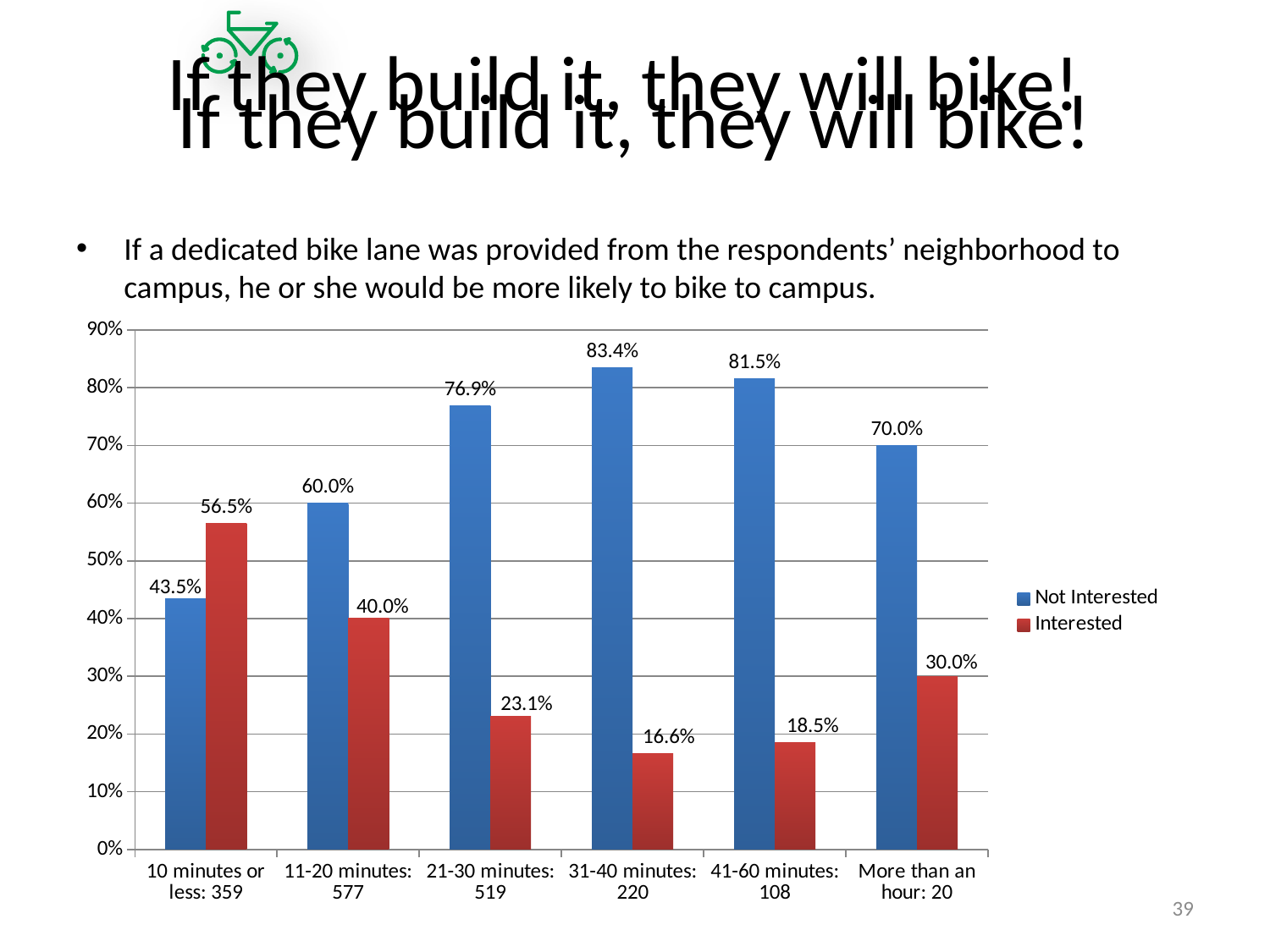
How many series does the legend list? 2 What is the Not Interested value for the 31-40 minutes: 220 category? 83.4% Which category has the highest Not Interested value? 31-40 minutes: 220 How many categories are shown on the x axis? 6 Which is larger for the 10 minutes or less: 359 category, Not Interested or Interested? Interested Which category has the lowest Interested value? 31-40 minutes: 220 What is the difference between the Not Interested and Interested values for the 11-20 minutes: 577 category? 20.0% Is the Not Interested value for the 21-30 minutes: 519 category greater or less than 70%? greater What is the Interested value for the 10 minutes or less: 359 category? 56.5% What is the Interested value for the More than an hour: 20 category? 30.0% Which colour represents the Interested series? Red What kind of chart is shown on the slide? Bar chart